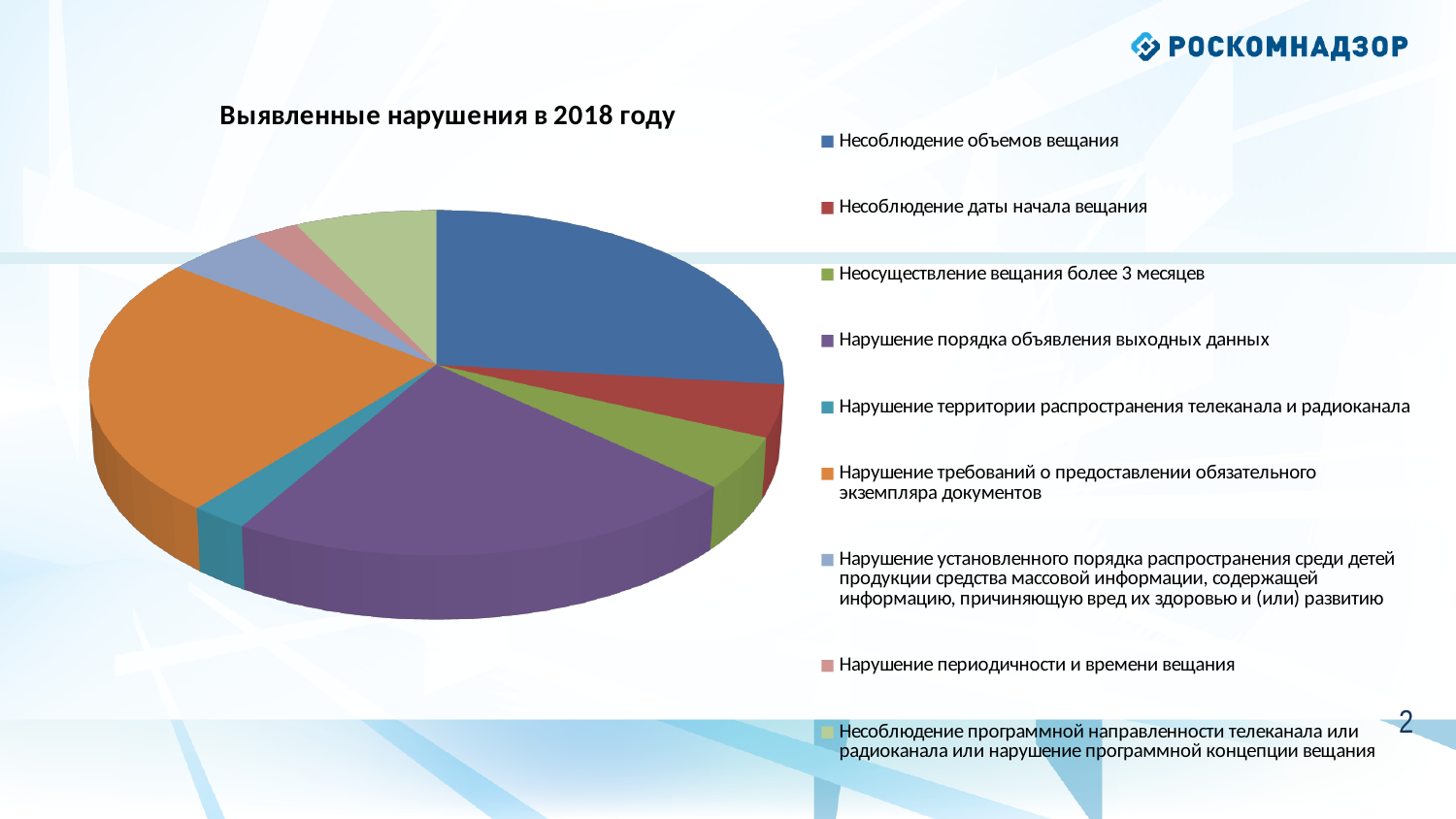
Which is larger: the slice for "Несоблюдение объемов вещания" or the slice for "Нарушение периодичности и времени вещания"? Несоблюдение объемов вещания Which is larger: the slice for "Нарушение требований о предоставлении обязательного экземпляра документов" or the slice for "Неосуществление вещания более 3 месяцев"? Нарушение требований о предоставлении обязательного экземпляра документов Which is larger: the slice for "Нарушение требований о предоставлении обязательного экземпляра документов" or the slice for "Нарушение установленного порядка распространения среди детей продукции средства массовой информации, содержащей информацию, причиняющую вред их здоровью и (или) развитию"? Нарушение требований о предоставлении обязательного экземпляра документов Which colour represents "Нарушение порядка объявления выходных данных" in the pie chart? purple What kind of chart is shown on the slide? pie chart What is the title of the chart? Выявленные нарушения в 2018 году How many categories (slices) does the pie chart's legend list? 9